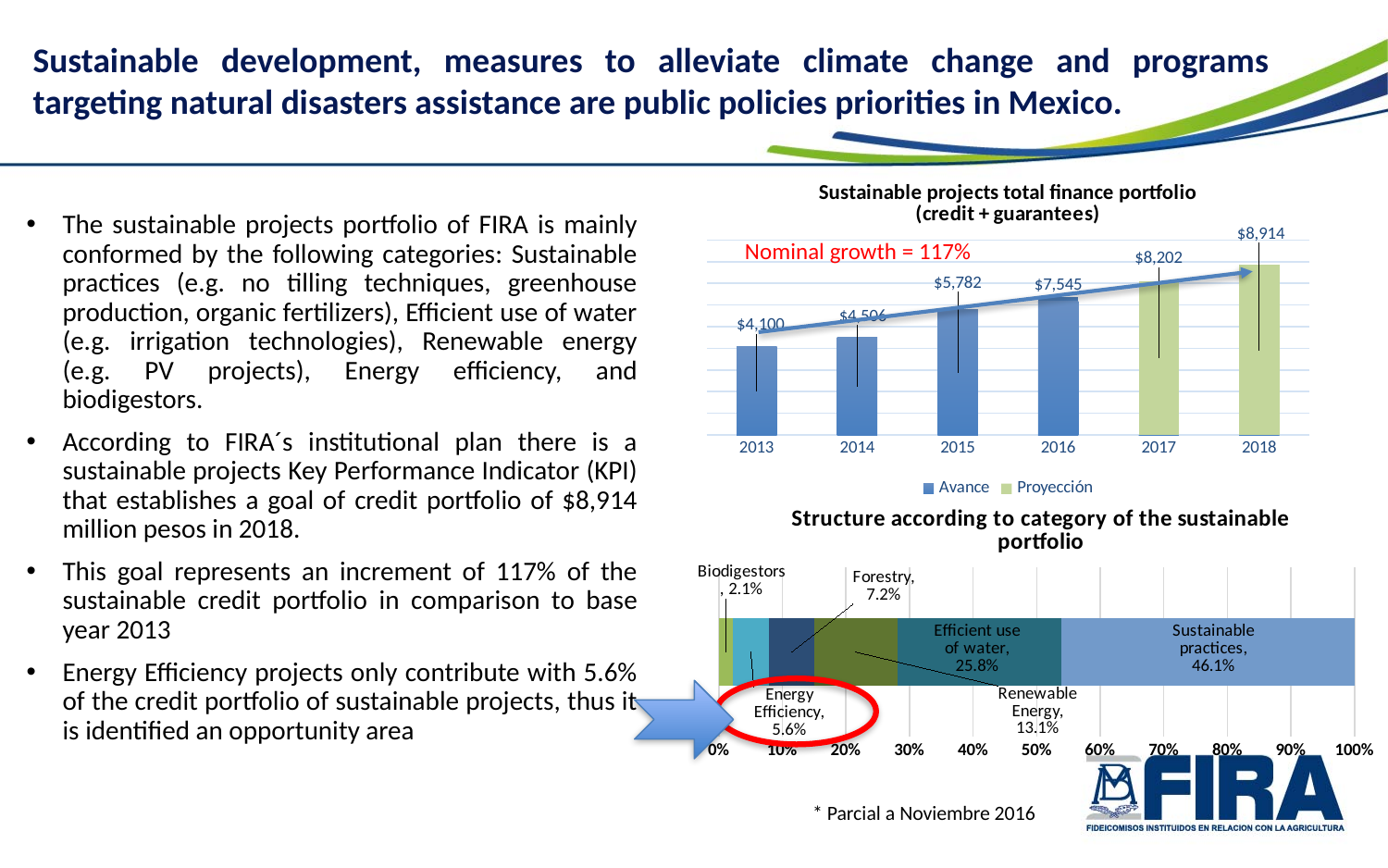
In the 'Structure according to category of the sustainable portfolio' chart, what is the share for Sustainable practices? 46.1% In the 'Sustainable projects total finance portfolio' chart, what is the value for 2013? $4,100 In the 'Structure according to category of the sustainable portfolio' chart, which category has the smallest share? Biodigestors In the 'Sustainable projects total finance portfolio' chart, do the values rise or fall from 2013 to 2018? rise How many series does the legend of the 'Sustainable projects total finance portfolio' chart list? 2 In the 'Sustainable projects total finance portfolio' chart, what is the difference between the 2018 and 2013 values? $4,814 In the 'Structure according to category of the sustainable portfolio' chart, what is the share for Energy Efficiency? 5.6% In the 'Sustainable projects total finance portfolio' chart, what is the value for 2016? $7,545 What type of chart is the 'Sustainable projects total finance portfolio' chart? bar chart In the 'Structure according to category of the sustainable portfolio' chart, which is larger: Renewable Energy or Forestry? Renewable Energy In the 'Sustainable projects total finance portfolio' chart, which year has the lowest value? 2013 In the 'Sustainable projects total finance portfolio' chart, what is the value for 2018? $8,914